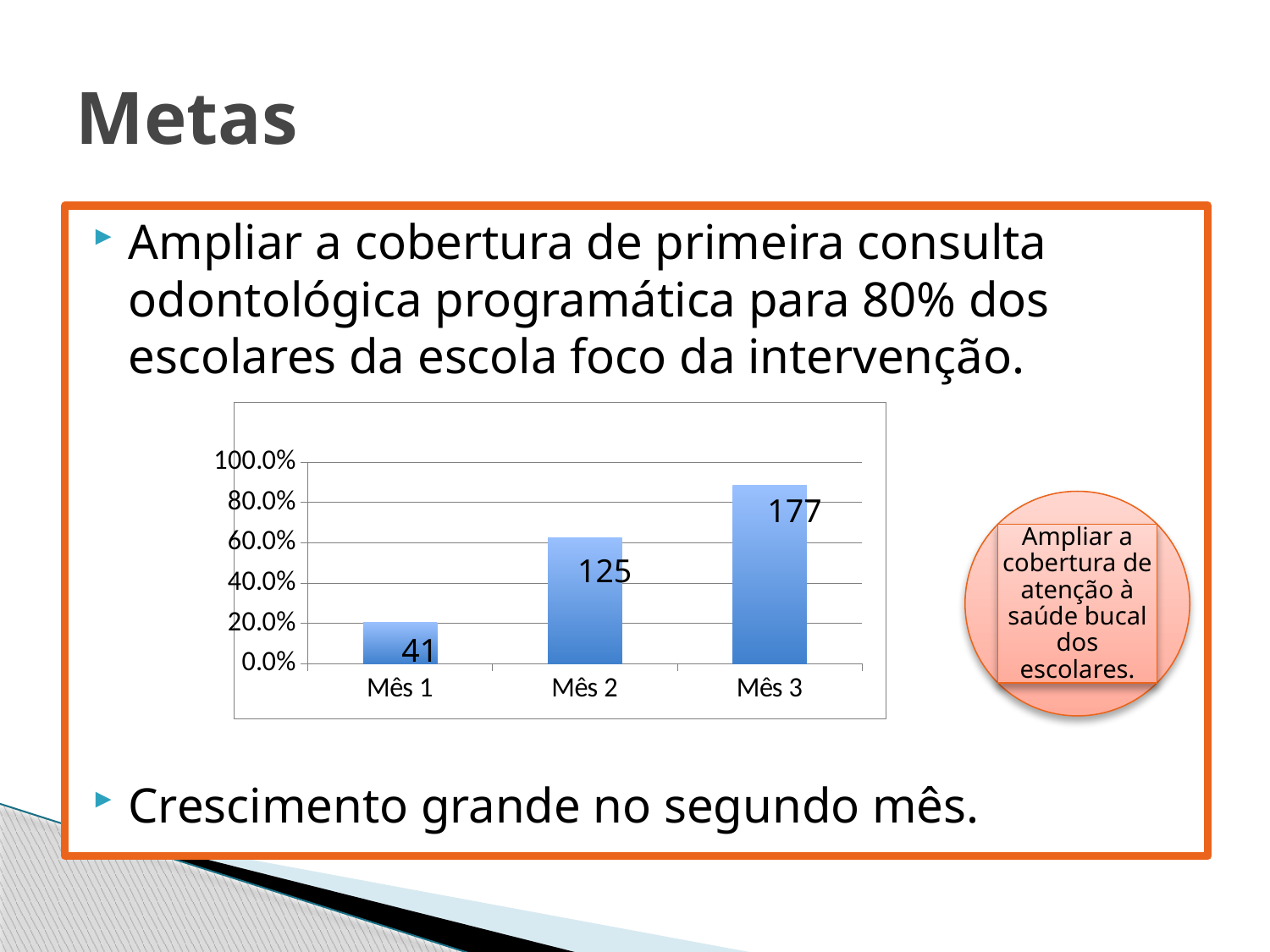
What is the data label shown on the bar for Mês 3? 177 What is the data label shown on the bar for Mês 1? 41 Which month has the lowest bar in the chart? Mês 1 How many months (categories) are shown on the x axis of the chart? 3 What kind of chart is shown on the slide? Bar chart What is the data label shown on the bar for Mês 2? 125 Is the bar for Mês 3 greater or less than 80.0% on the axis? greater Is the bar for Mês 1 greater or less than 40.0% on the axis? less Which month has the highest bar in the chart? Mês 3 What is the difference between the data labels for Mês 3 and Mês 1? 136 Which is larger, the value for Mês 2 or the value for Mês 3? Mês 3 What is the difference between the data labels for Mês 2 and Mês 1? 84